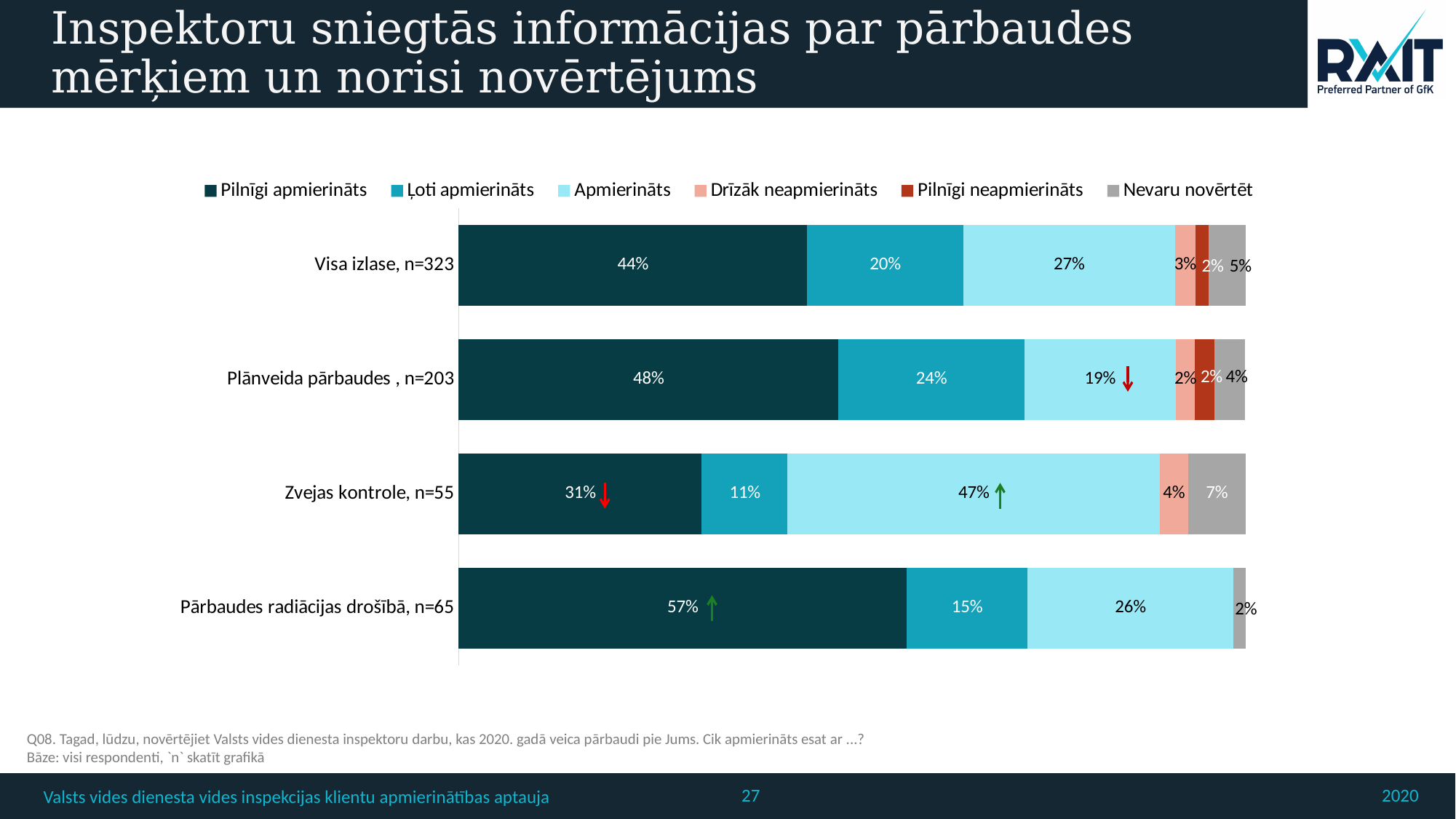
Which is larger: the 'Apmierināts' value for 'Visa izlase, n=323' or for 'Plānveida pārbaudes , n=203'? Visa izlase, n=323 What is the 'Nevaru novērtēt' value for 'Pārbaudes radiācijas drošībā, n=65'? 2% Which category has the highest 'Pilnīgi apmierināts' value? Pārbaudes radiācijas drošībā, n=65 What is the difference between the 'Pilnīgi apmierināts' values for 'Pārbaudes radiācijas drošībā, n=65' and 'Zvejas kontrole, n=55'? 26% Which legend entry is shown in the grey colour? Nevaru novērtēt How many categories (bars) are shown in the chart? 4 Which category has the lowest 'Ļoti apmierināts' value? Zvejas kontrole, n=55 What kind of chart is shown on the slide? Stacked bar chart How many series does the legend list? 6 What is the 'Pilnīgi apmierināts' value for 'Visa izlase, n=323'? 44% What is the 'Apmierināts' value for 'Zvejas kontrole, n=55'? 47% What is the 'Ļoti apmierināts' value for 'Plānveida pārbaudes , n=203'? 24%